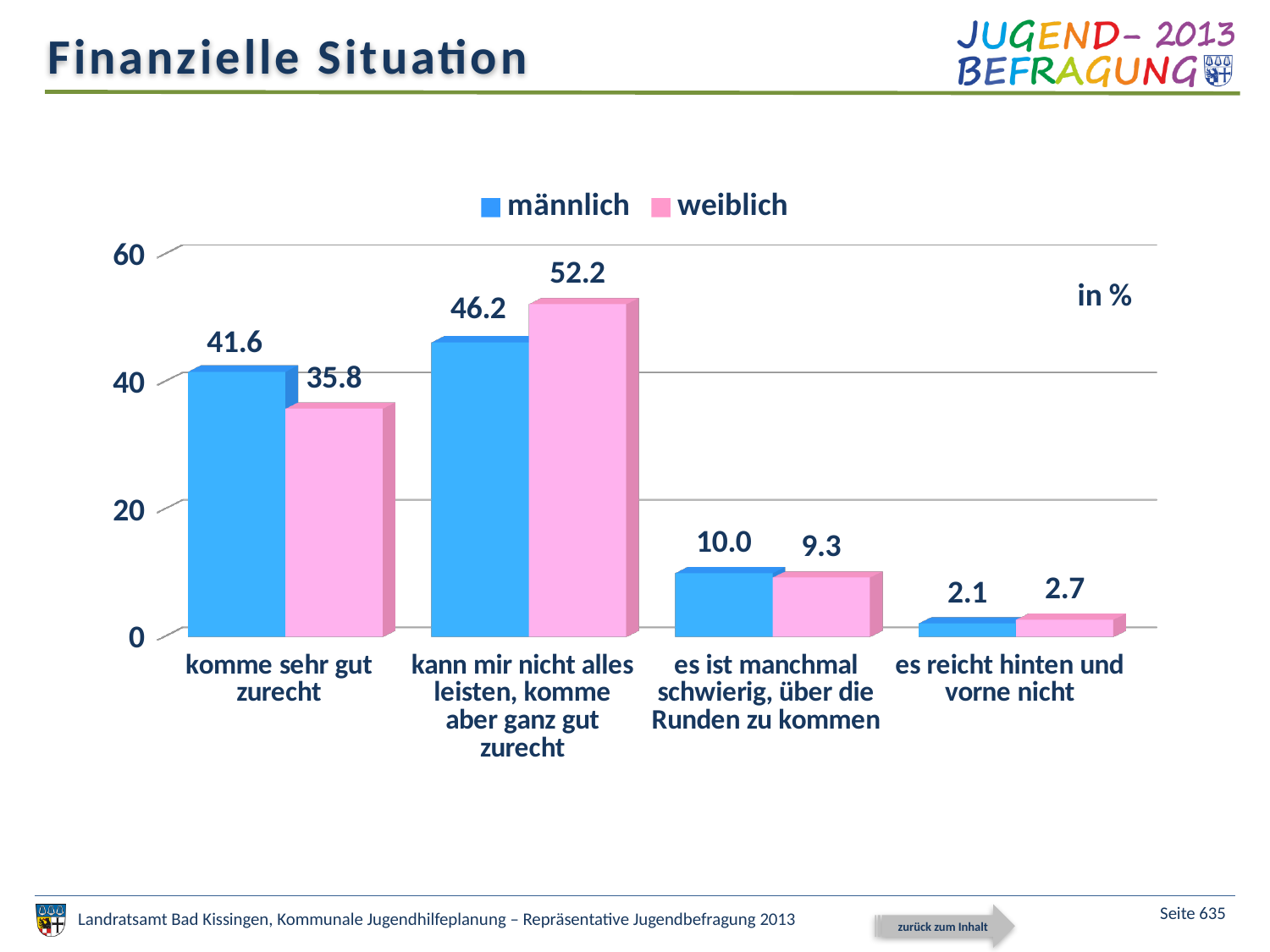
What is the difference between the weiblich and männlich values in the category "kann mir nicht alles leisten, komme aber ganz gut zurecht"? 6.0 What kind of chart is shown on the slide? bar chart In the category "komme sehr gut zurecht", which series has the larger value, männlich or weiblich? männlich What is the value for männlich in the category "komme sehr gut zurecht"? 41.6 How many categories are shown on the x axis? 4 Which category has the highest value for weiblich? kann mir nicht alles leisten, komme aber ganz gut zurecht Is the männlich value for "es ist manchmal schwierig, über die Runden zu kommen" greater or less than 20? less What is the value for weiblich in the category "kann mir nicht alles leisten, komme aber ganz gut zurecht"? 52.2 How many series does the legend list? 2 Which category has the lowest value for männlich? es reicht hinten und vorne nicht What unit is indicated for the values in the chart? in % What is the value for weiblich in the category "es reicht hinten und vorne nicht"? 2.7